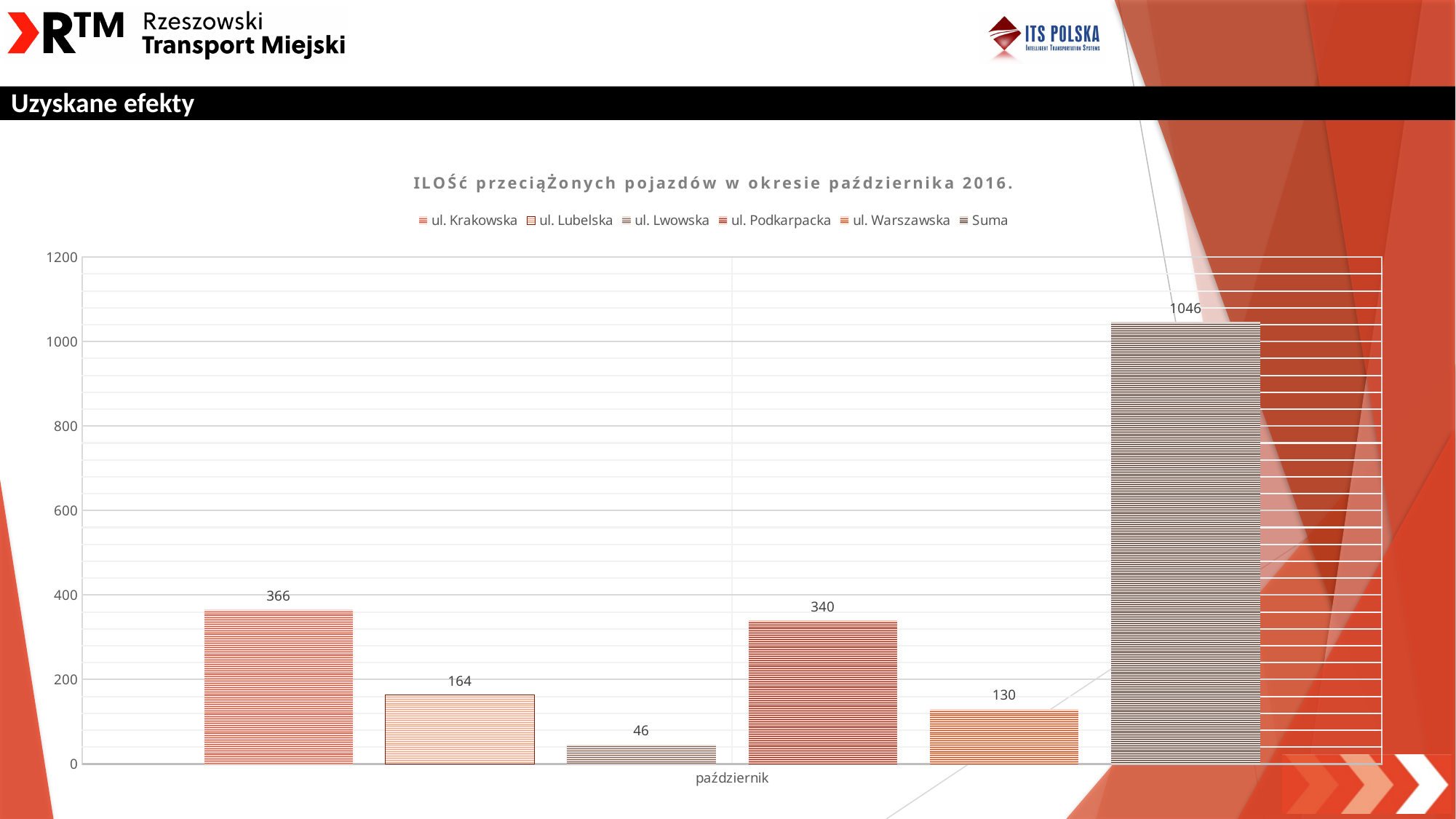
What is the value for Suma? 1046 Which series has the lowest value? ul. Lwowska What is the difference between the values for ul. Krakowska and ul. Podkarpacka? 26 What is the value for ul. Podkarpacka? 340 How many series does the legend list? 6 Excluding Suma, which street has the highest value? ul. Krakowska What kind of chart is shown on the slide? bar chart What is the value for ul. Krakowska? 366 Which is larger, the value for ul. Lubelska or ul. Warszawska? ul. Lubelska What is the value for ul. Lwowska? 46 What is the value for ul. Lubelska? 164 What is the value for ul. Warszawska? 130